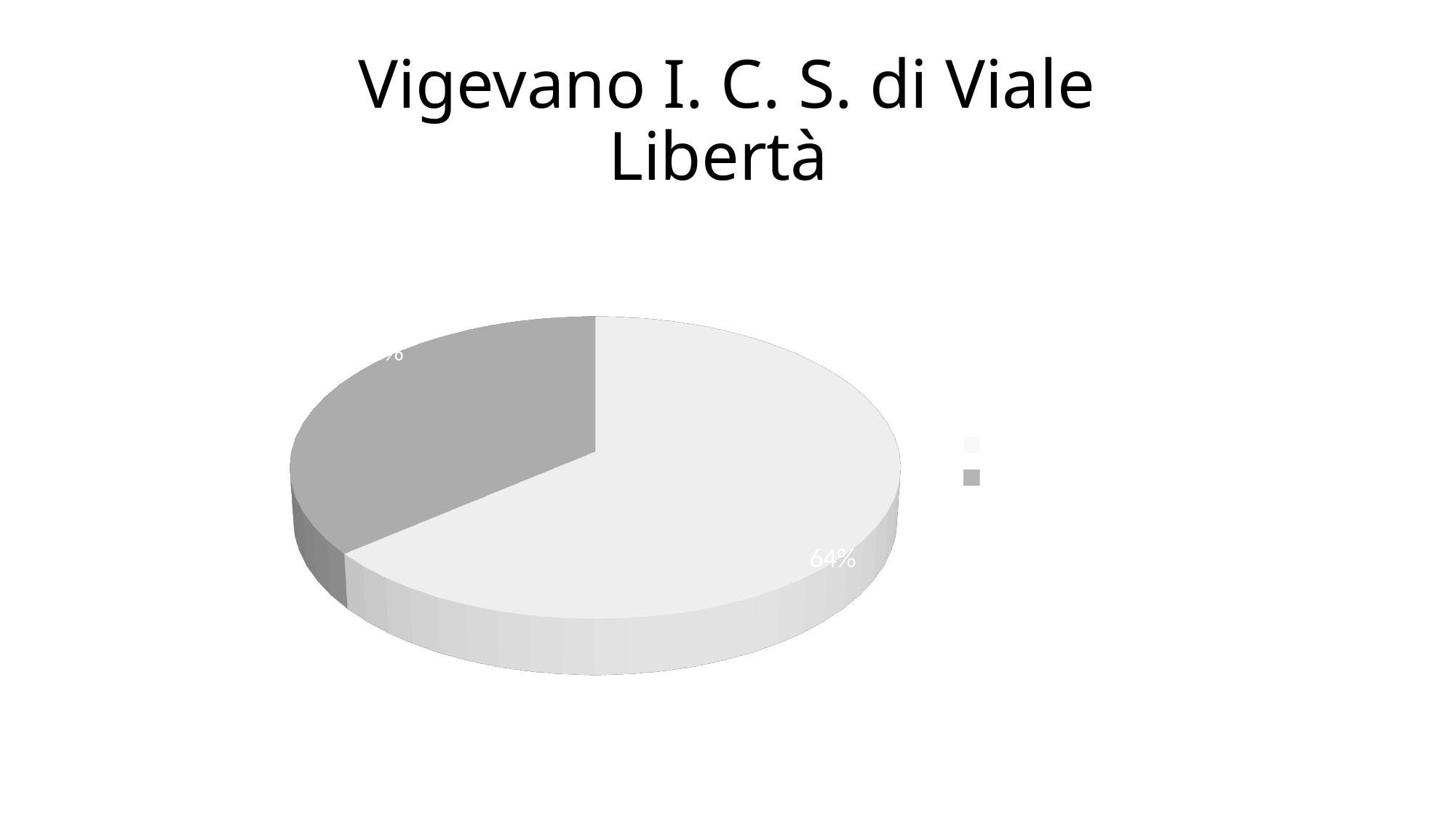
How many entries does the legend list? 2 How many slices does the pie chart have? 2 Which slice of the pie chart is the largest? the light-coloured slice (64%) Which slice of the pie chart is the smallest? the grey slice Which slice is larger, the light-coloured slice or the grey slice? the light-coloured slice What is the title of the chart? Vigevano I. C. S. di Viale Libertà What percentage is shown on the light-coloured slice of the pie chart? 64% What kind of chart is shown on the slide? pie chart